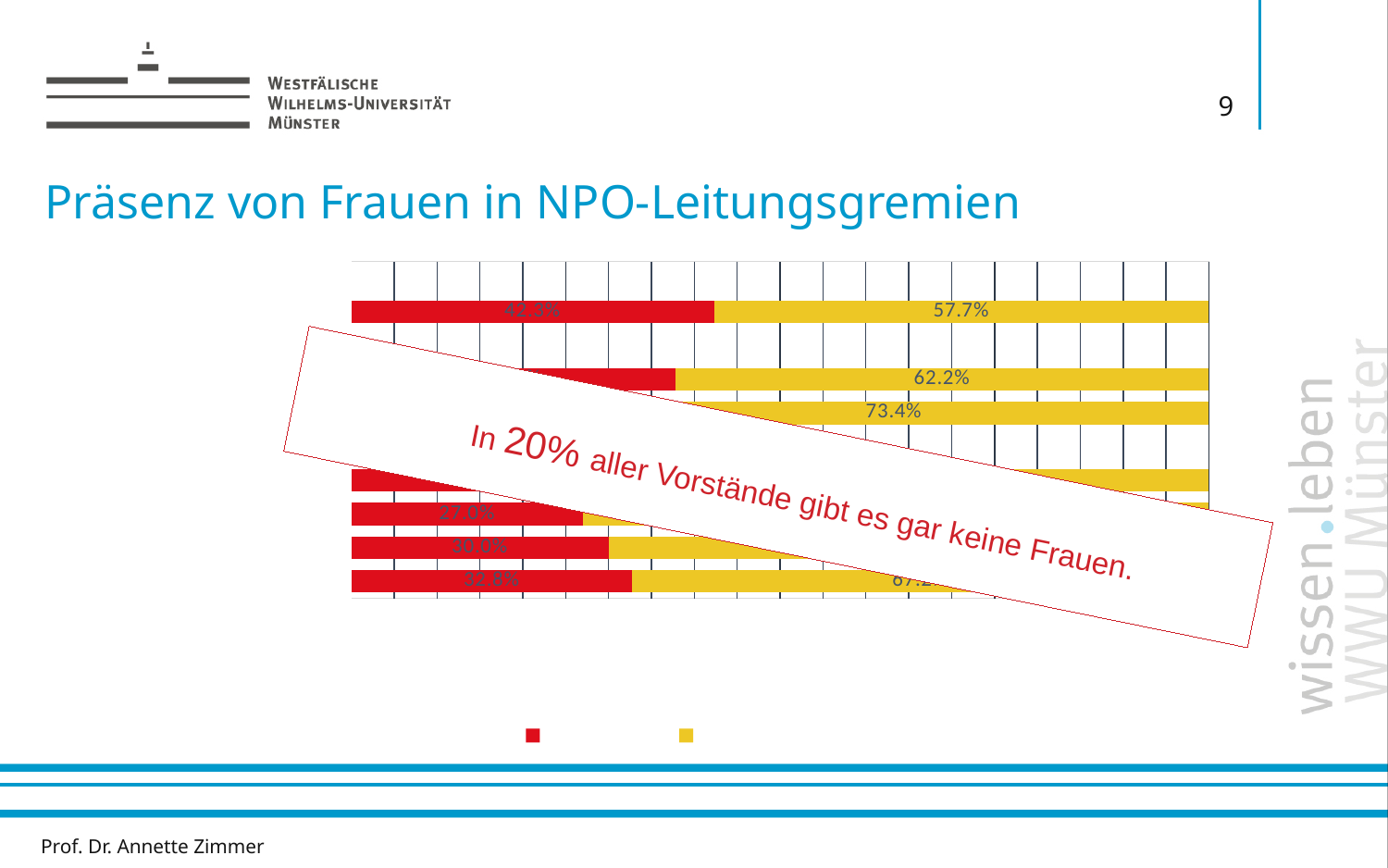
What is the value of the yellow segment in the second bar from the top? 62.2% In the top bar, which segment is larger, the red one or the yellow one? the yellow one What kind of chart is shown on the slide? bar chart What is the title of the slide containing the chart? Präsenz von Frauen in NPO-Leitungsgremien What is the value of the yellow segment in the third bar from the top? 73.4% What does the text box overlaid on the chart say? In 20% aller Vorstände gibt es gar keine Frauen. What is the value of the red segment in the bottom bar of the chart? 32.8% What is the difference between the yellow and red segments in the top bar? 15.4 percentage points What is the total of the red and yellow segments in the top bar? 100% What is the value of the red segment in the top bar of the chart? 42.3% What is the value of the yellow segment in the top bar of the chart? 57.7% How many series does the chart's legend list? 2